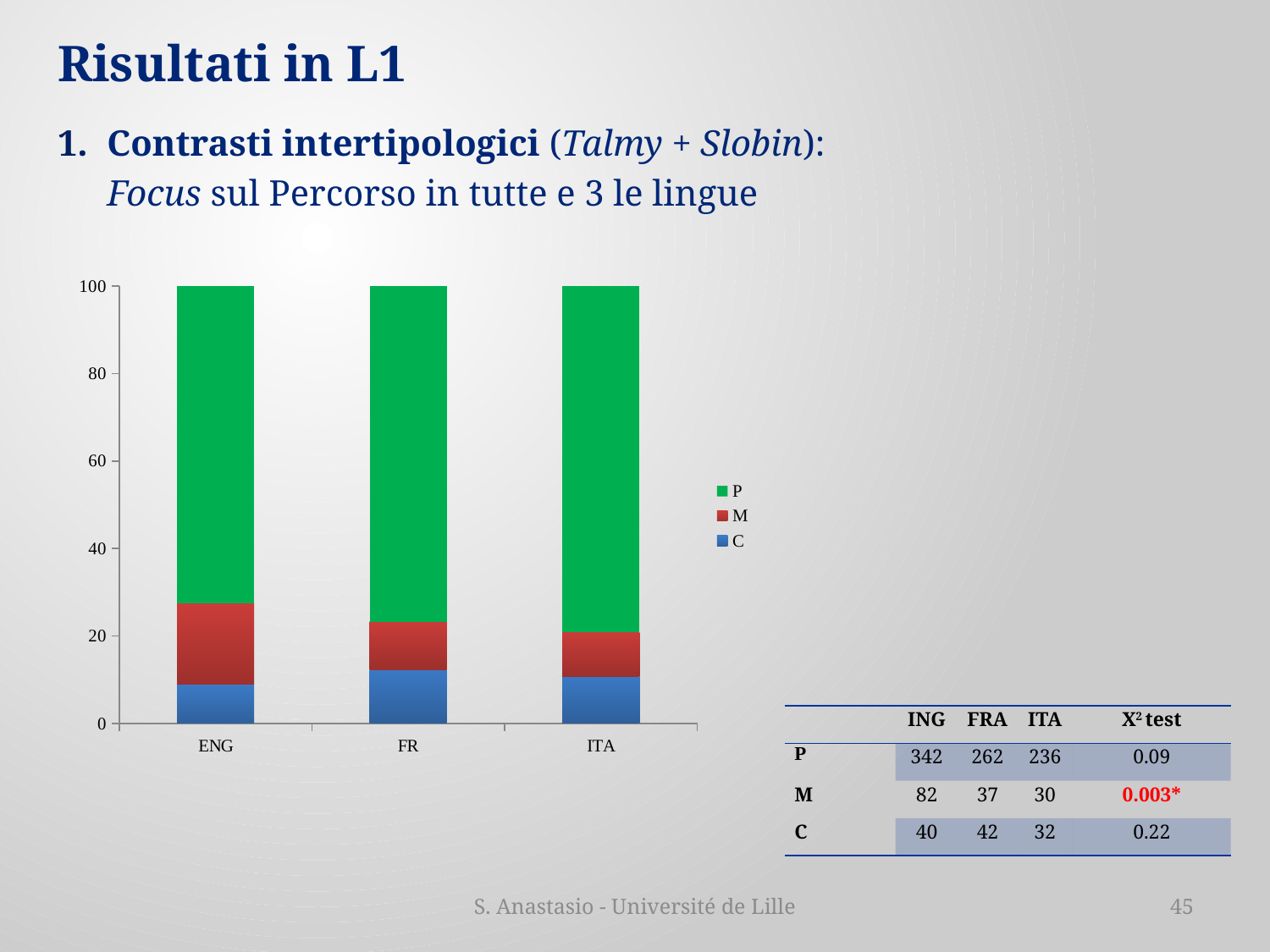
Which colour represents the series P in the chart? green Is the value of the C segment for ENG greater or less than 20? less Is the value of the M segment for ITA greater or less than 20? less What are the series names listed in the chart legend? P, M, C How many series does the chart legend list? 3 Is the value of the P segment for ENG greater or less than 60? greater What kind of chart is shown on the slide? stacked bar chart How many categories are shown on the x axis of the chart? 3 Which category has the smallest C segment? ENG What is the total height of the ENG stacked bar? 100 Is the M segment larger for ENG or for ITA? ENG Which category has the largest M segment? ENG